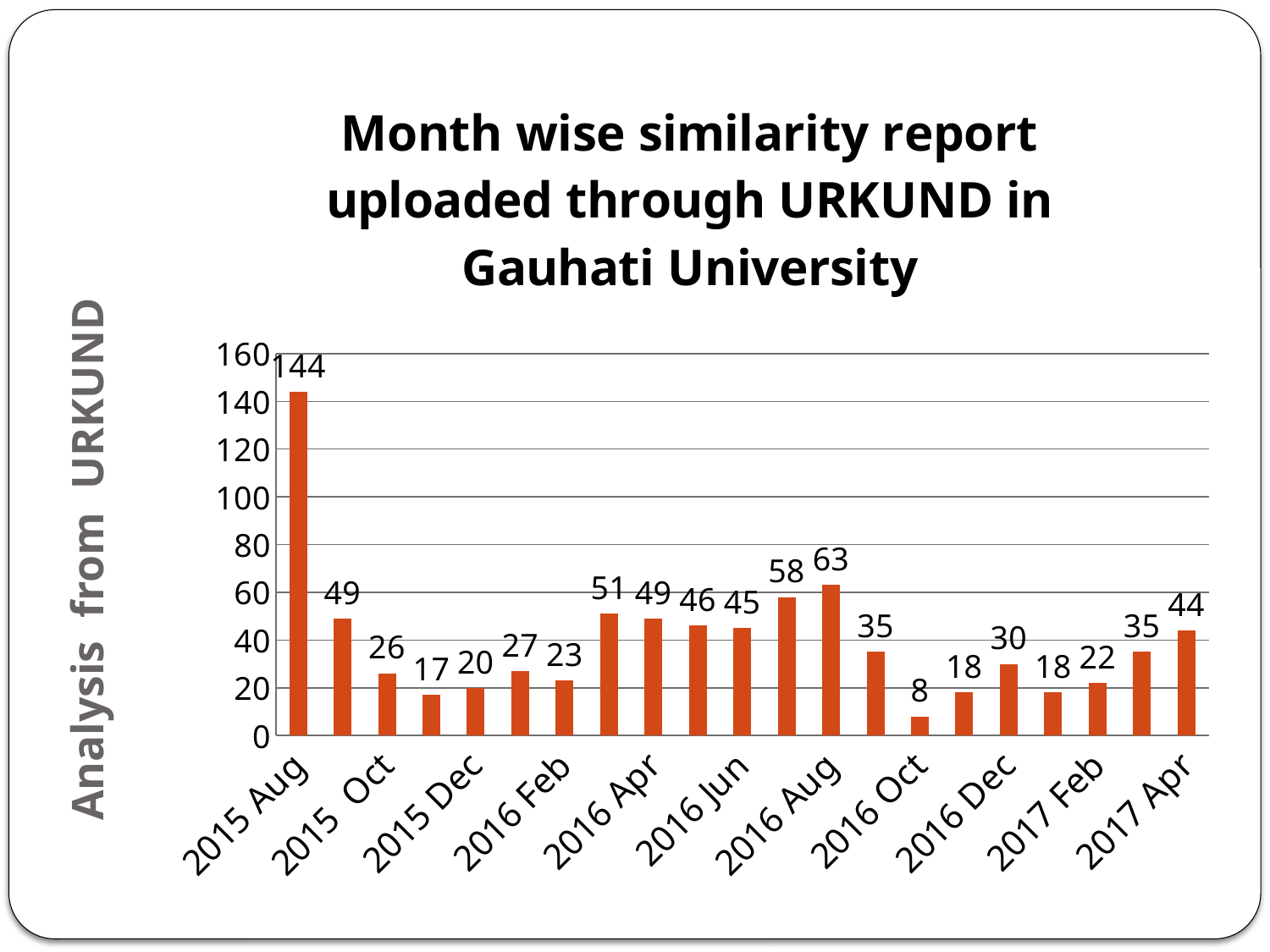
What is the value for 2015 Aug? 144 What is the value for 2017 Apr? 44 What is the title of the chart? Month wise similarity report uploaded through URKUND in Gauhati University Which month has the highest value? 2015 Aug What kind of chart is shown on the slide? Bar chart What is the value for 2016 Oct? 8 Which month has the lowest value? 2016 Oct Is the value for 2016 Jun greater or less than 40? greater What is the value for 2016 Aug? 63 What is the difference between the values for 2015 Aug and 2016 Aug? 81 Which is larger, the value for 2016 Apr or the value for 2016 Dec? 2016 Apr How many bars are plotted in the chart? 21